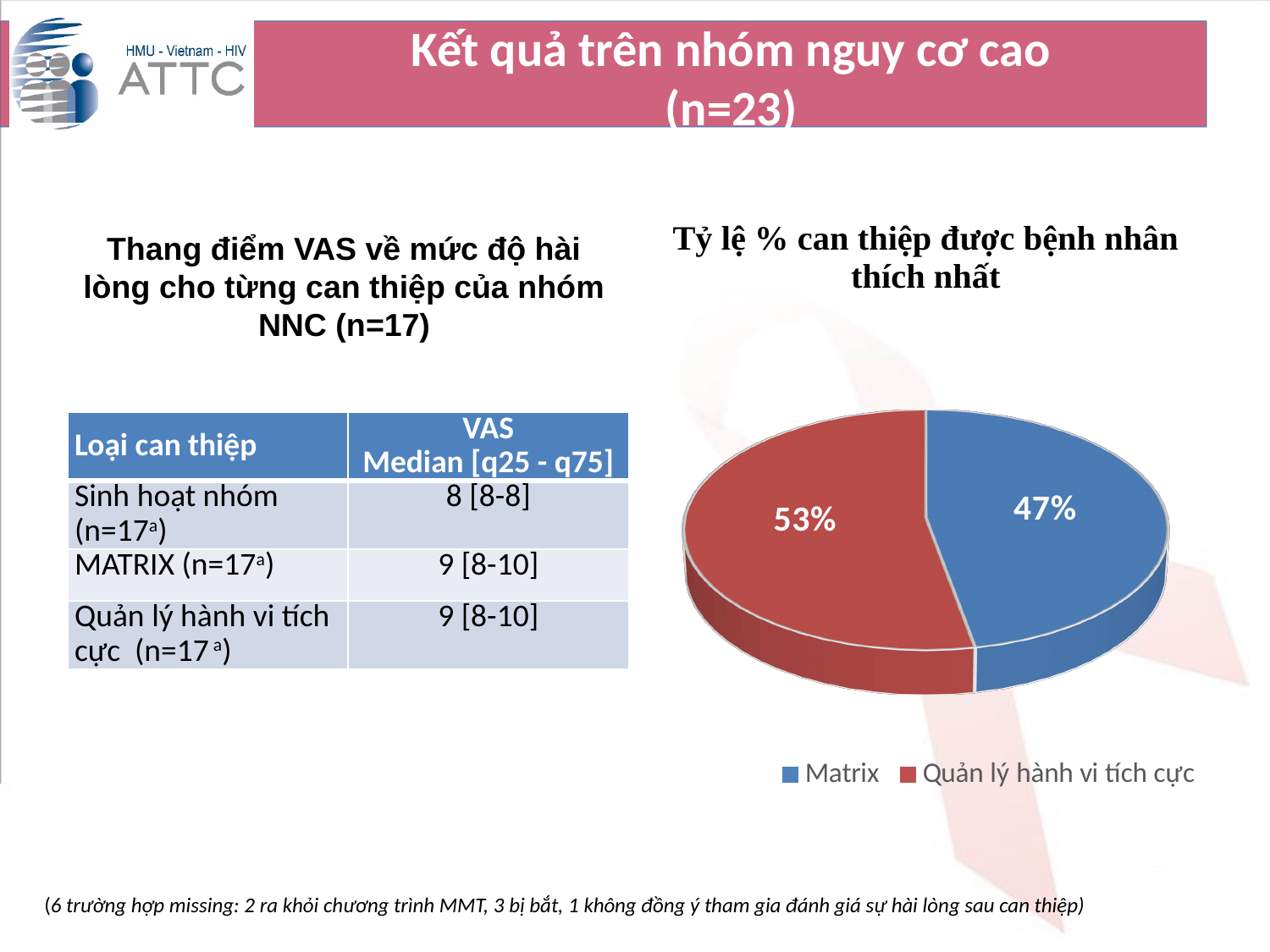
Which is larger in the pie chart, Matrix or Quản lý hành vi tích cực? Quản lý hành vi tích cực What share of the pie chart does Matrix have? 47% How many slices does the pie chart have? 2 What share of the pie chart does Quản lý hành vi tích cực have? 53% What is the difference in percentage points between the Quản lý hành vi tích cực slice and the Matrix slice? 6 What kind of chart is shown on the slide? Pie chart Which slice of the pie chart is the largest? Quản lý hành vi tích cực How many entries does the pie chart's legend list? 2 Which slice of the pie chart is the smallest? Matrix What colour is the Matrix slice in the pie chart? Blue Is the Matrix slice of the pie chart greater or less than 50%? less What is the title of the pie chart? Tỷ lệ % can thiệp được bệnh nhân thích nhất